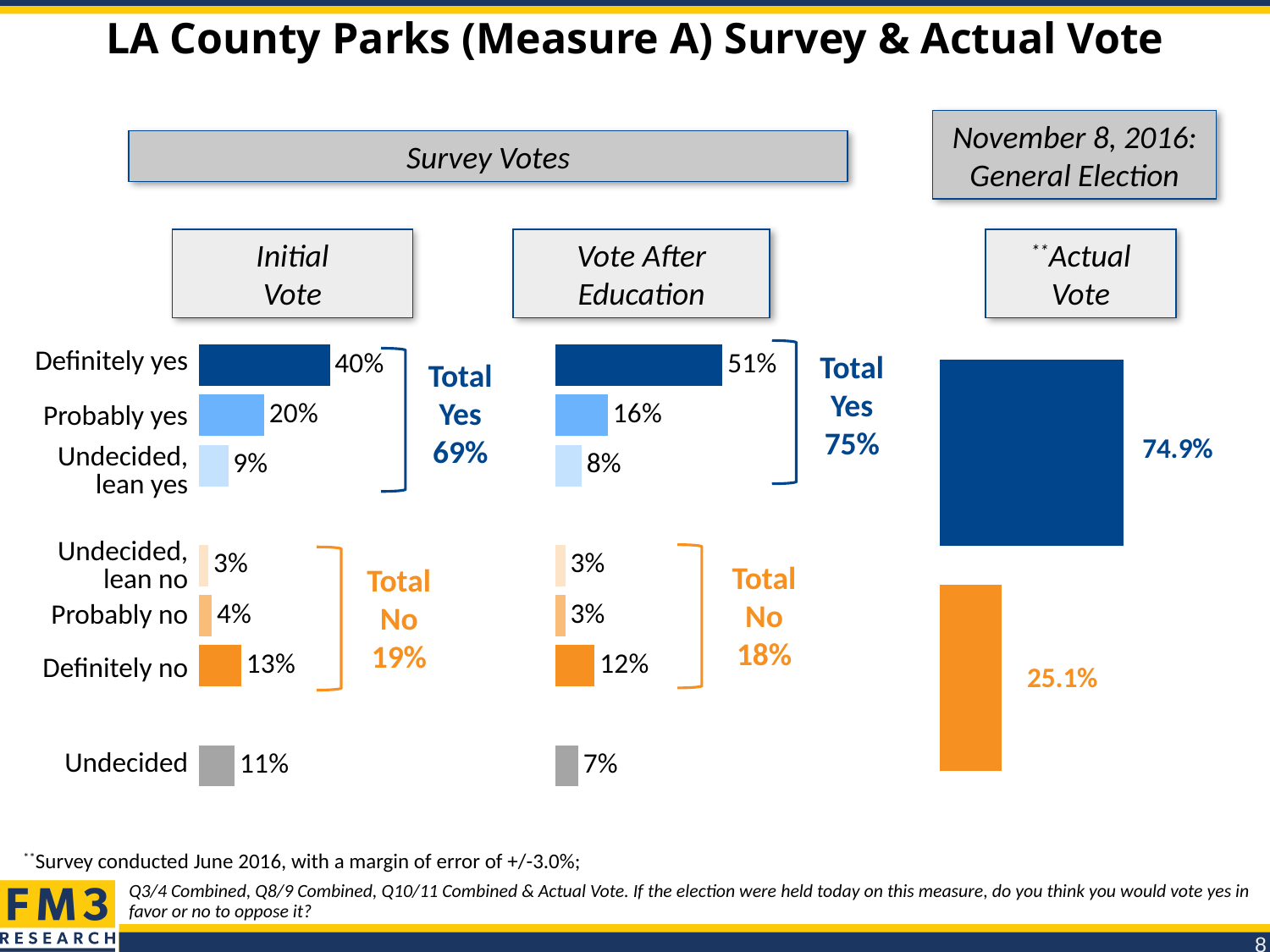
What is the Total Yes shown for the Vote After Education chart? 75% What is the difference between Definitely yes in the Vote After Education chart and Definitely yes in the Initial Vote chart? 11 percentage points How many response categories are shown in the Initial Vote chart? 7 In the Vote After Education chart, what percentage is shown for Definitely yes? 51% What is the Total No shown for the Initial Vote chart? 19% In the Initial Vote chart, what percentage is shown for Definitely yes? 40% Which is larger: Undecided in the Initial Vote chart or Undecided in the Vote After Education chart? Initial Vote (11%) In the Actual Vote chart, what percentage is shown for the no vote? 25.1% In the Actual Vote chart, what percentage is shown for the yes vote? 74.9% In the Initial Vote chart, which category has the highest value? Definitely yes What type of chart is used to show the Initial Vote results? Bar chart In the Vote After Education chart, which category has the lowest value? Undecided, lean no and Probably no (both 3%)